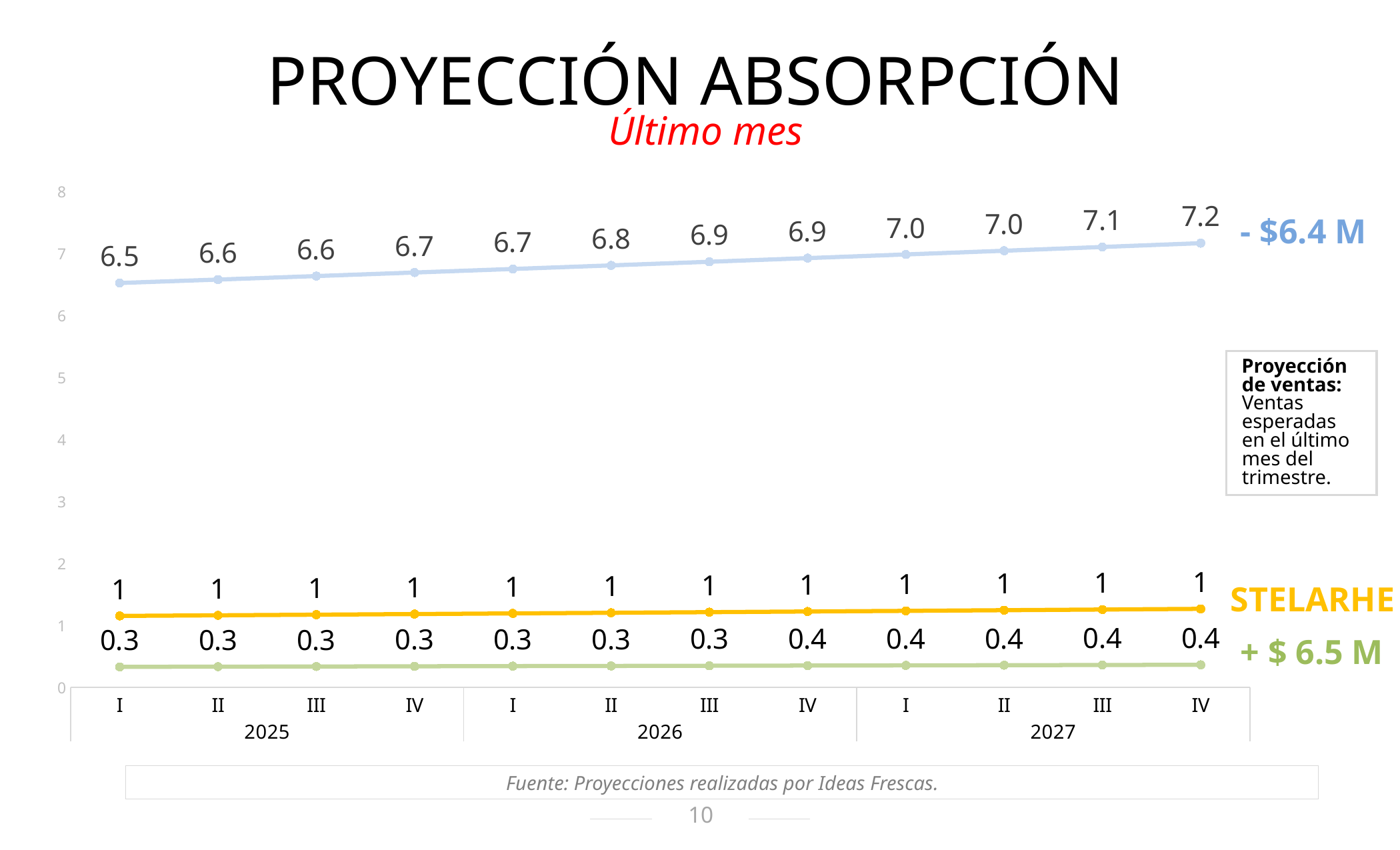
Does the "- $6.4 M" series rise or fall from 2025 to 2027? rise What is the value of the "+ $ 6.5 M" series in quarter II of 2026? 0.3 What is the value of the "- $6.4 M" series in quarter I of 2025? 6.5 How many quarterly data points does each series have? 12 Which series has the higher value in quarter I of 2026, STELARHE or "+ $ 6.5 M"? STELARHE What is the value of the STELARHE series in quarter III of 2027? 1 What is the value of the "- $6.4 M" series in quarter IV of 2027? 7.2 What type of chart is shown on the slide? line chart In which quarter does the "- $6.4 M" series reach its highest value? IV 2027 What is the difference between the "- $6.4 M" series value in quarter IV of 2027 and in quarter I of 2025? 0.7 What is the value of the "- $6.4 M" series in quarter III of 2026? 6.9 What is the red subtitle under the chart title? Último mes